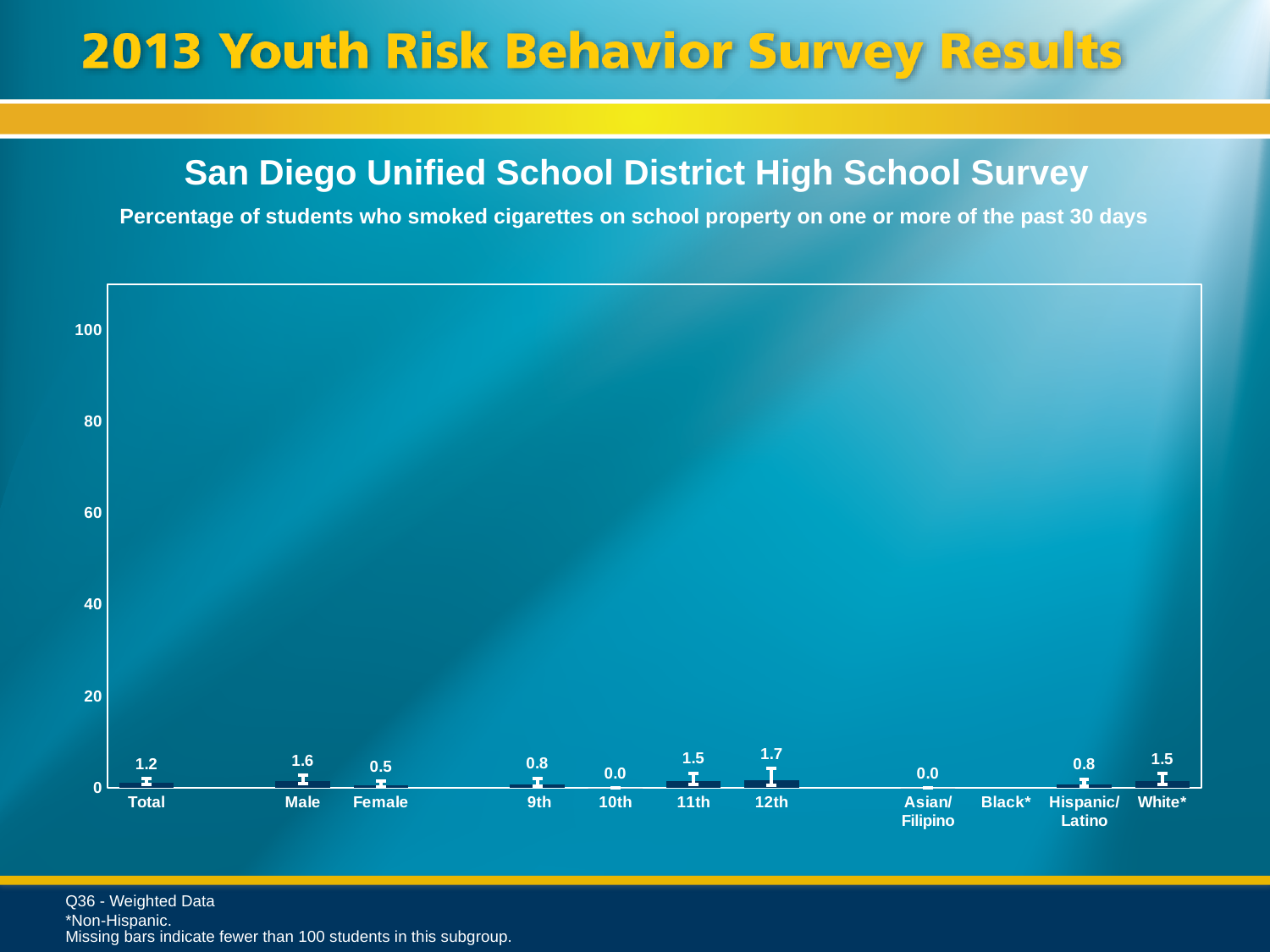
What is the value for Total? 1.2 What is the difference between the values for Male and Female? 1.1 What is the title of the chart? San Diego Unified School District High School Survey What kind of chart is shown on the slide? bar chart Which category has the highest value? 12th What is the value for Female? 0.5 Among the grade levels (9th, 10th, 11th, 12th), which has the lowest value? 10th How many categories are labelled on the x axis? 11 Is the value for White* greater or less than 20? less Which is larger, the value for Male or the value for Total? Male What is the value for Hispanic/Latino? 0.8 What is the value for 12th grade? 1.7